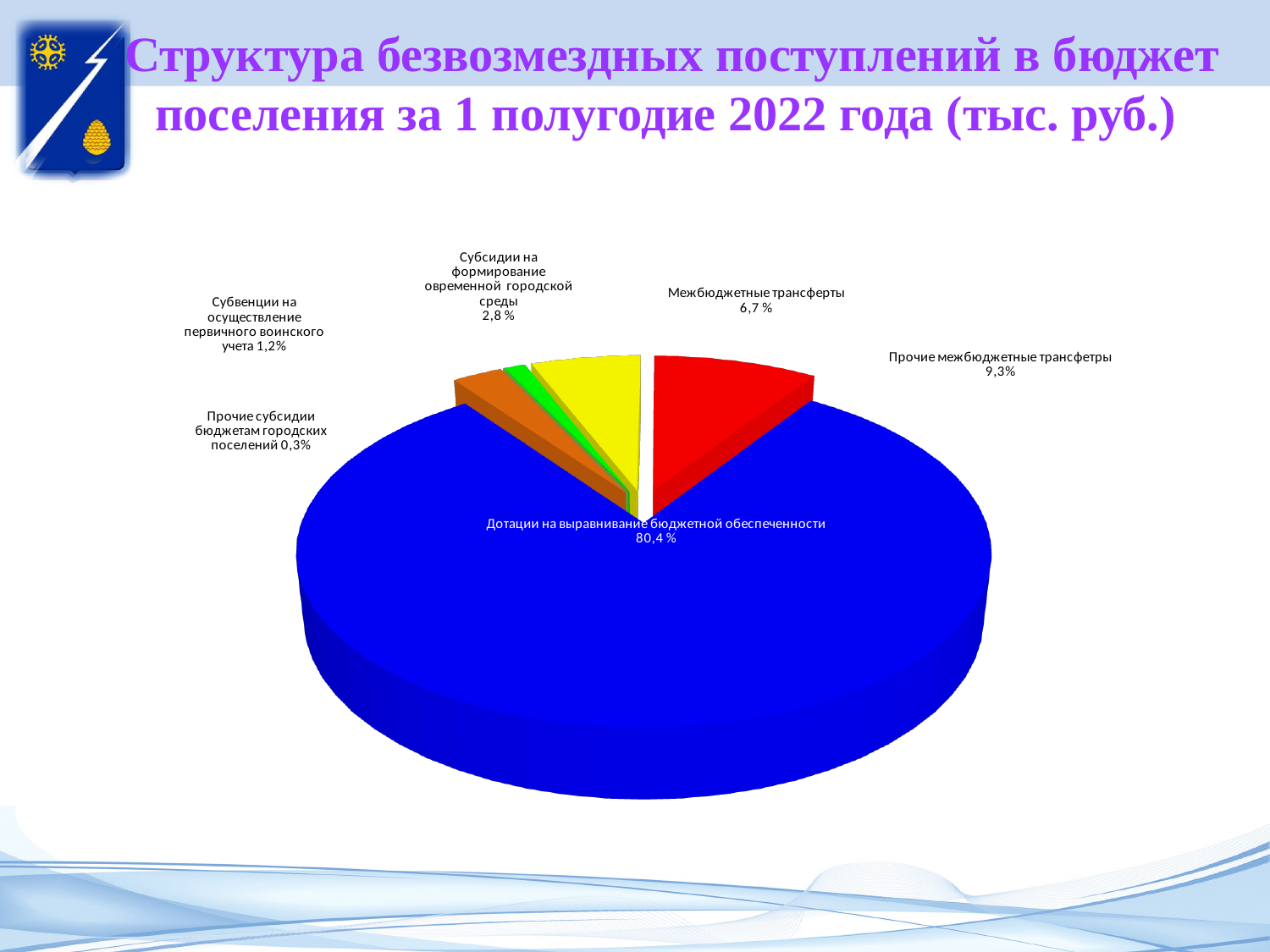
What kind of chart is shown on the slide? pie chart What share is shown for Субсидии на формирование современной городской среды? 2,8 % What share is shown for Межбюджетные трансферты? 6,7 % What share is shown for Прочие субсидии бюджетам городских поселений? 0,3% Which is larger: the share for Прочие межбюджетные трансферты or the share for Межбюджетные трансферты? Прочие межбюджетные трансферты Which category has the largest share of the pie? Дотации на выравнивание бюджетной обеспеченности Which category has the smallest share of the pie? Прочие субсидии бюджетам городских поселений What colour is the slice for Дотации на выравнивание бюджетной обеспеченности? blue How many categories (slices) does the pie chart have? 6